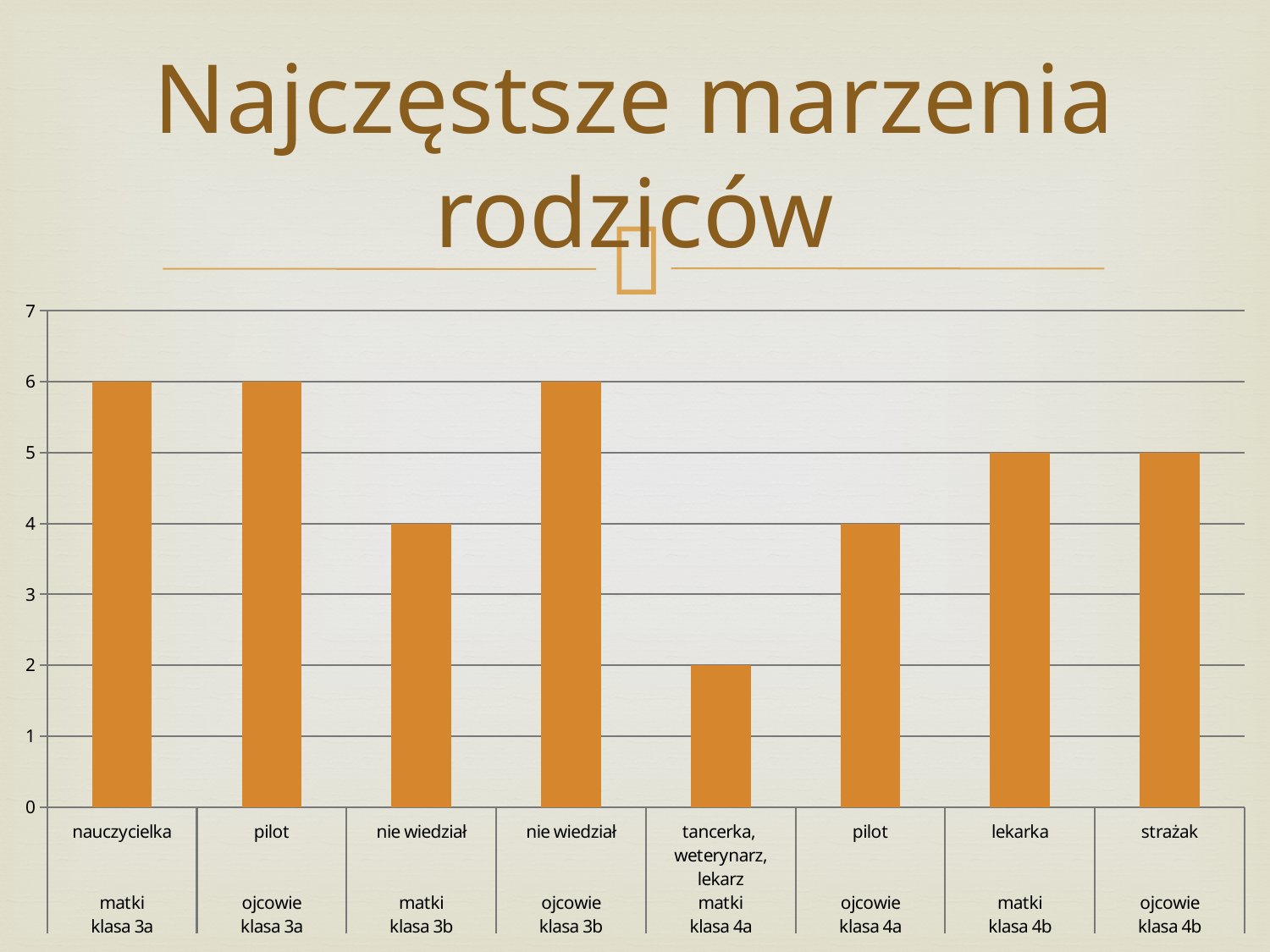
What is the difference between the bar for 'nie wiedział' (ojcowie klasa 3b) and the bar for 'nie wiedział' (matki klasa 3b)? 2 What is the value of the bar for 'lekarka' (matki klasa 4b)? 5 What is the value of the bar for 'pilot' (ojcowie klasa 4a)? 4 What is the title of the slide? Najczęstsze marzenia rodziców What is the value of the bar for 'nauczycielka' (matki klasa 3a)? 6 Which is larger: the bar for 'strażak' (ojcowie klasa 4b) or the bar for 'pilot' (ojcowie klasa 4a)? strażak (ojcowie klasa 4b) Which category has the lowest bar? tancerka, weterynarz, lekarz (matki klasa 4a) How many bars does the chart have? 8 What is the value of the bar for 'tancerka, weterynarz, lekarz' (matki klasa 4a)? 2 Is the value for 'pilot' (ojcowie klasa 3a) greater or less than 5? greater What kind of chart is shown on the slide? bar chart What is the highest value shown on the vertical axis? 7